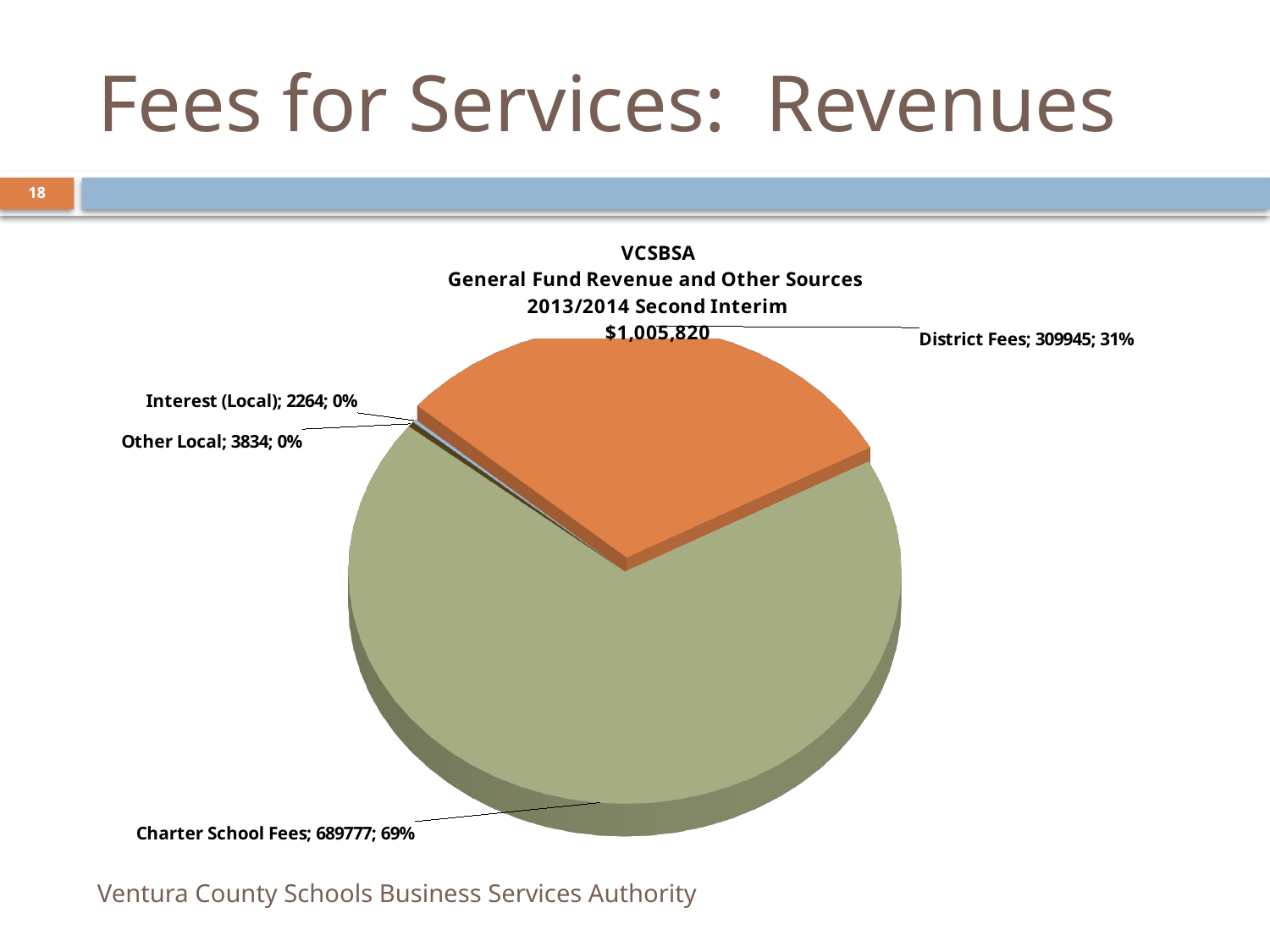
How many categories are shown in the pie chart? 4 Which category has the smallest slice of the pie? Interest (Local) What is the value for Other Local? 3834 What is the value for Charter School Fees? 689777 What kind of chart is shown on the slide? pie chart What share of the pie is Charter School Fees? 69% What is the value for Interest (Local)? 2264 Which is larger, Other Local or Interest (Local)? Other Local What share of the pie is District Fees? 31% Which category has the largest slice of the pie? Charter School Fees What is the value for District Fees? 309945 What is the difference between Charter School Fees and District Fees? 379832